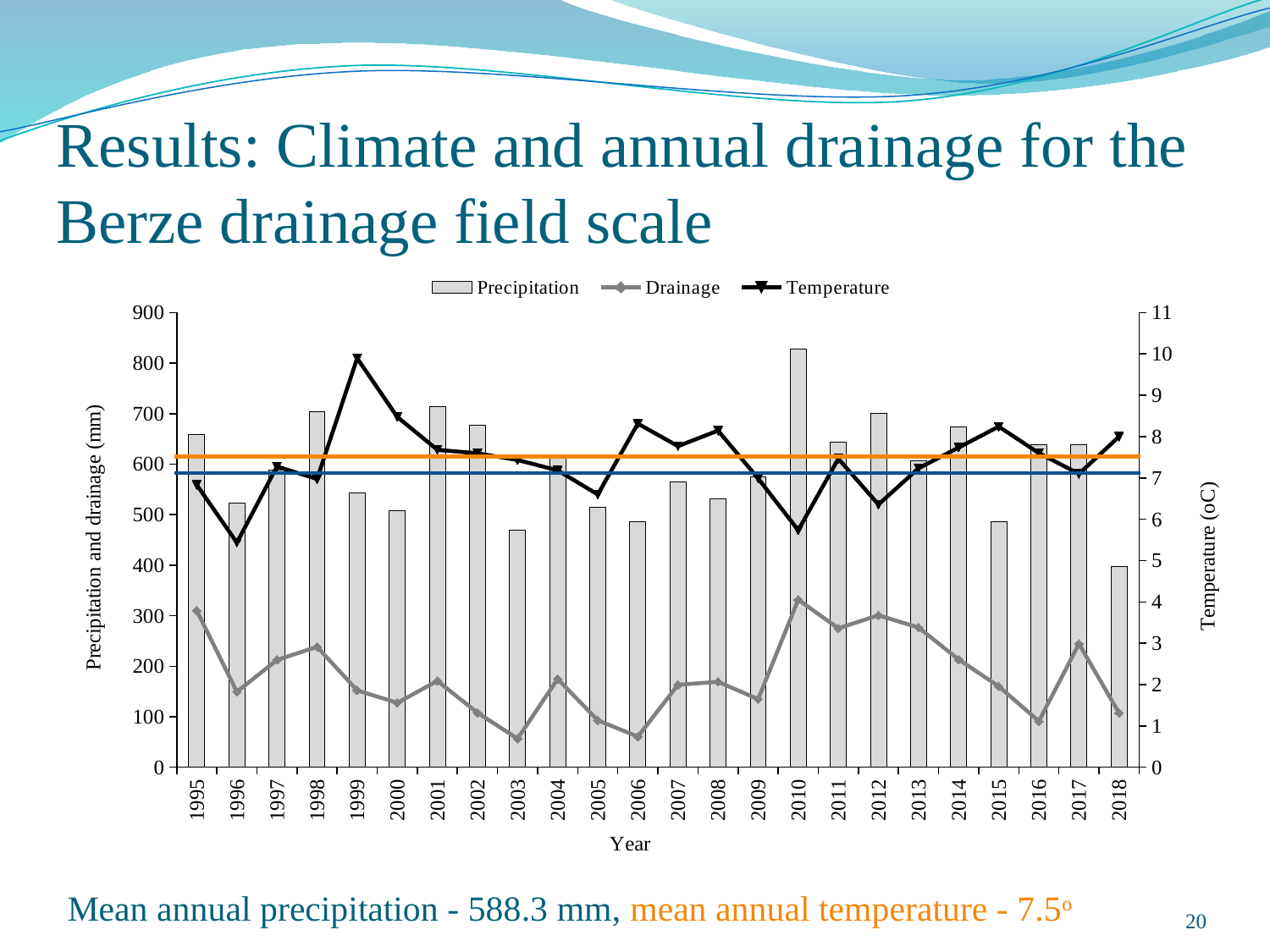
Is the temperature value for 1999 greater or less than 9? greater Which year has the highest precipitation bar? 2010 How many series does the legend list? 3 How many years are shown on the x axis? 24 Which year has the highest temperature? 1999 Which year has the highest drainage value? 2010 What kind of chart is shown on the slide? A combined bar and line chart Is the precipitation value for 2010 greater or less than 800? greater Does the drainage line rise or fall from 2012 to 2016? fall Which year has the lowest temperature? 1996 Is the precipitation value for 2003 greater or less than 500? less Which has the larger precipitation bar, 2010 or 2018? 2010